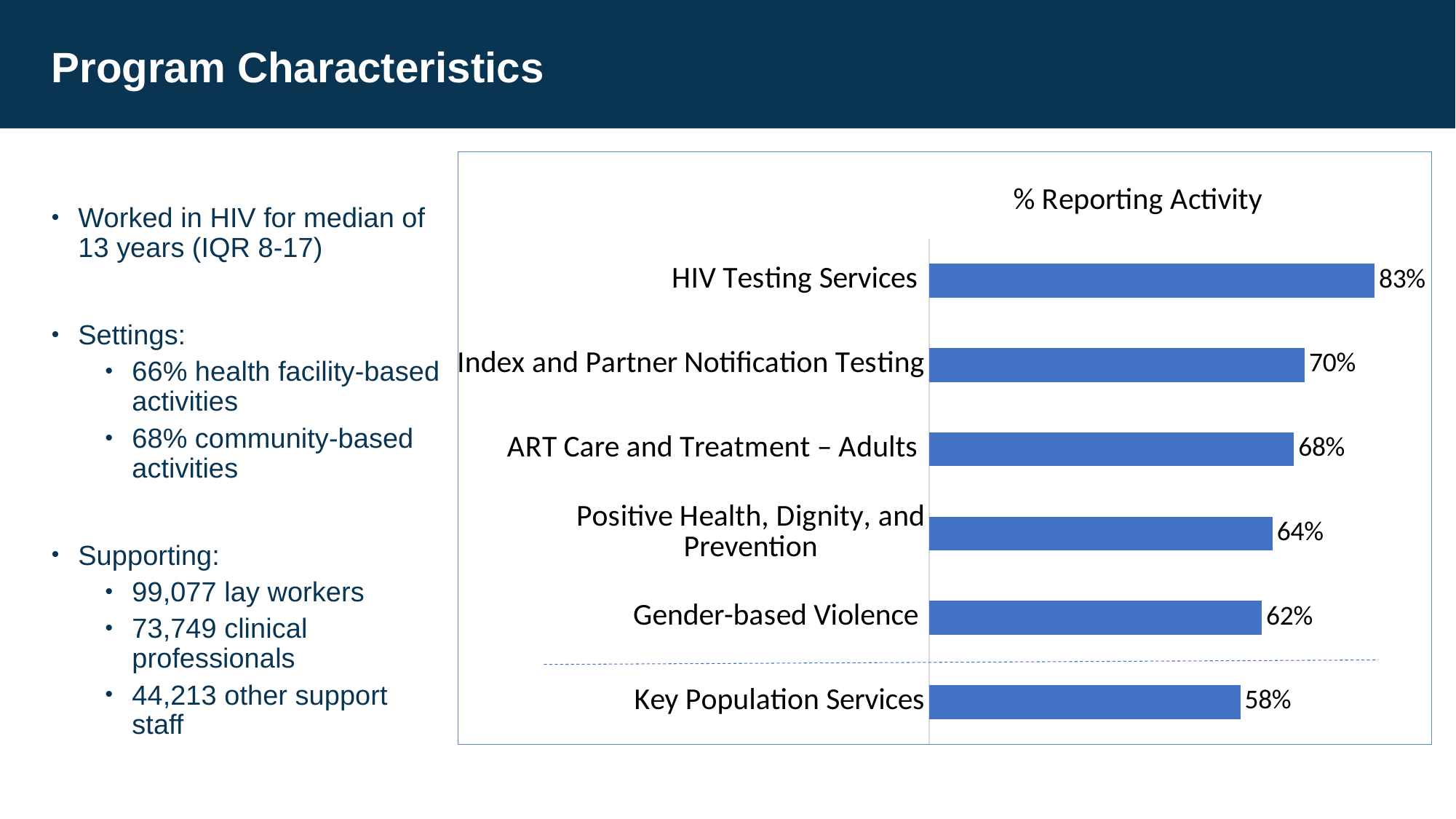
What is the value for Index and Partner Notification Testing? 70% What percentage reported HIV Testing Services activity? 83% Which activity has the highest percentage reporting? HIV Testing Services What is the difference between HIV Testing Services and Key Population Services? 25% What is the difference between Index and Partner Notification Testing and Gender-based Violence? 8% What is the value for ART Care and Treatment – Adults? 68% What is the value for Key Population Services? 58% What type of chart is shown? Bar chart How many activities are shown in the chart? 6 What is the value for Positive Health, Dignity, and Prevention? 64% Which is larger, Gender-based Violence or Positive Health, Dignity, and Prevention? Positive Health, Dignity, and Prevention Which activity has the lowest percentage reporting? Key Population Services